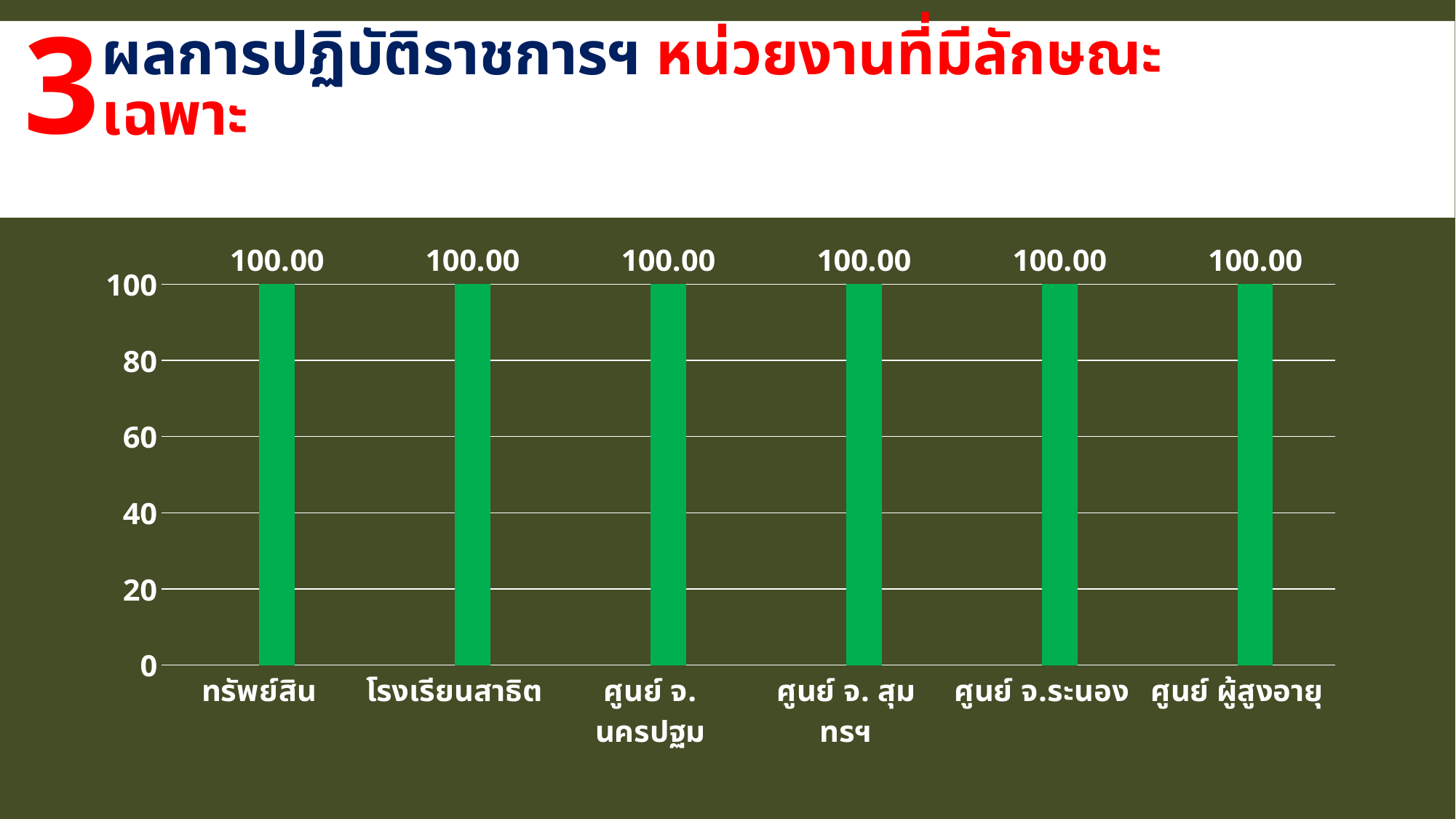
What is the value for ศูนย์ จ.ระนอง? 100.00 What is the value for ศูนย์ จ.นครปฐม? 100.00 What is the value for ศูนย์ ผู้สูงอายุ? 100.00 What is the value for ทรัพย์สิน? 100.00 What is the value for ศูนย์ จ. สุมทรฯ? 100.00 What is the difference between the values for ทรัพย์สิน and ศูนย์ ผู้สูงอายุ? 0.00 What kind of chart is shown on the slide? bar chart Is the value for ศูนย์ จ.ระนอง greater or less than 80? greater How many categories are shown on the x axis of the chart? 6 What is the value for โรงเรียนสาธิต? 100.00 Do the values rise, fall, or stay the same across the categories from left to right? stay the same What colour are the bars in the chart? green